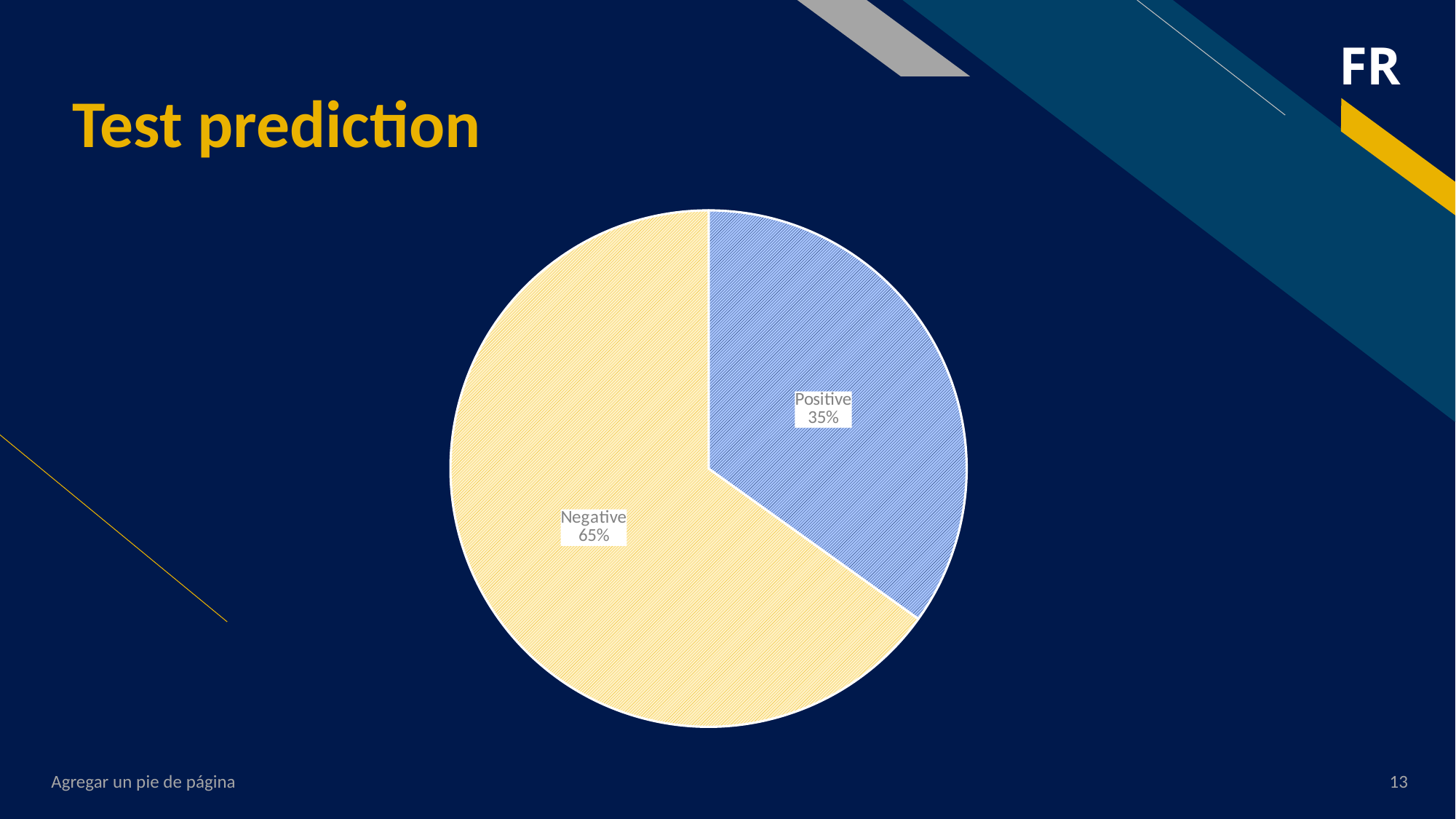
How many slices does the pie chart have? 2 Which slice is the largest in the pie chart? Negative What kind of chart is shown on the slide? pie chart What colour is the Positive slice of the pie chart? blue What share of the pie does the Positive slice represent? 35% Which slice is the smallest in the pie chart? Positive What share of the pie does the Negative slice represent? 65% What is the title of the slide containing the pie chart? Test prediction Which is larger, the Positive slice or the Negative slice? Negative What is the difference in percentage points between the Negative and Positive slices? 30 percentage points